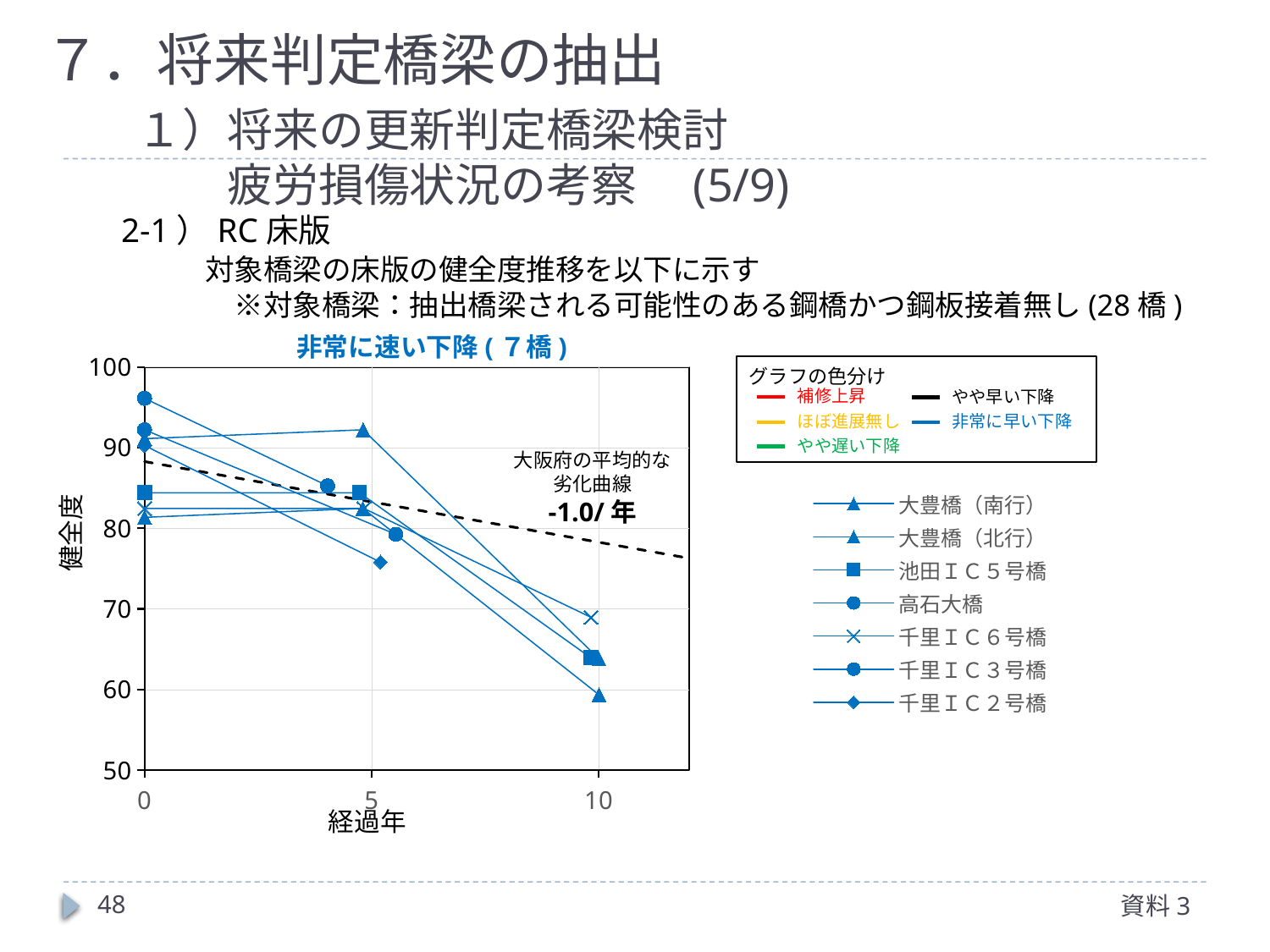
Do the plotted values generally rise or fall as 経過年 increases? fall What is the title shown above the chart? 非常に速い下降（7橋） Is the value for 池田IC5号橋 at 経過年 0 greater or less than 80? greater Is the value for 千里IC2号橋 at 経過年 5 greater or less than 80? less At 経過年 10, which is larger: the value for 千里IC6号橋 or the value for 池田IC5号橋? 千里IC6号橋 How many series does the chart's legend list? 7 What kind of chart is shown on the slide? line chart Is the value for 池田IC5号橋 at 経過年 10 greater or less than 70? less At 経過年 5, which is larger: the value for 池田IC5号橋 or the value for 千里IC2号橋? 池田IC5号橋 What is the slope written next to the dashed line labelled 大阪府の平均的な劣化曲線? -1.0/年 What is the label of the y axis of the chart? 健全度